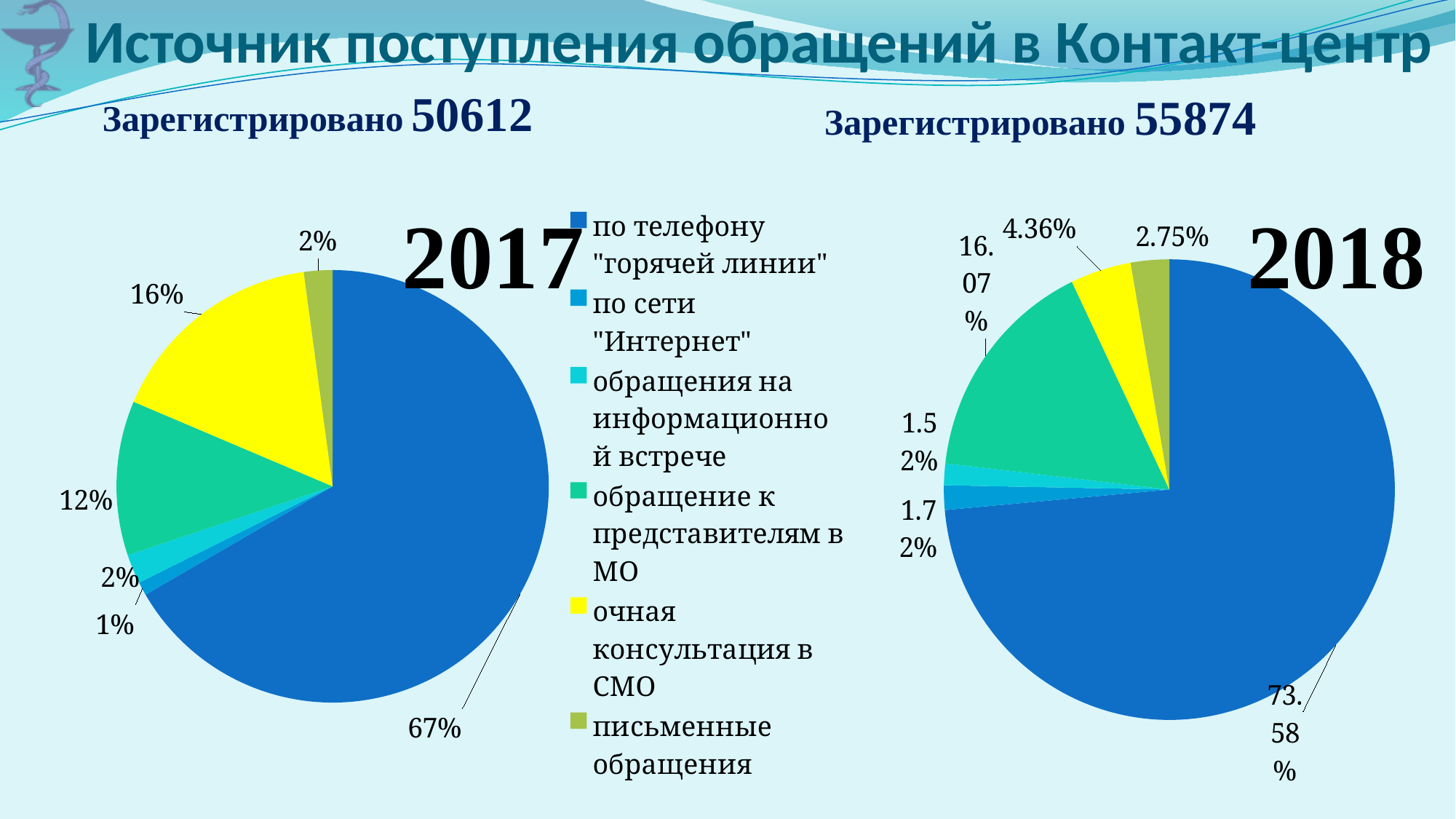
In the 2017 pie chart, what share of requests came по телефону "горячей линии"? 67% In the 2018 pie chart, which is larger: the share for очная консультация в СМО or for письменные обращения? очная консультация в СМО In the 2017 pie chart, what is the share for очная консультация в СМО? 16% What type of chart is used for the 2018 data? pie chart How many slices does the 2017 pie chart have? 6 In the 2017 pie chart, which source has the smallest share? по сети "Интернет" In the 2018 pie chart, what share of requests came по телефону "горячей линии"? 73.58% In the 2018 pie chart, which source has the largest share? по телефону "горячей линии" In the 2017 pie chart, what is the difference between the shares for очная консультация в СМО and обращение к представителям в МО? 4% In the 2018 pie chart, what is the share for письменные обращения? 2.75% How many entries does the legend list? 6 In the 2018 pie chart, what is the share for обращение к представителям в МО? 16.07%